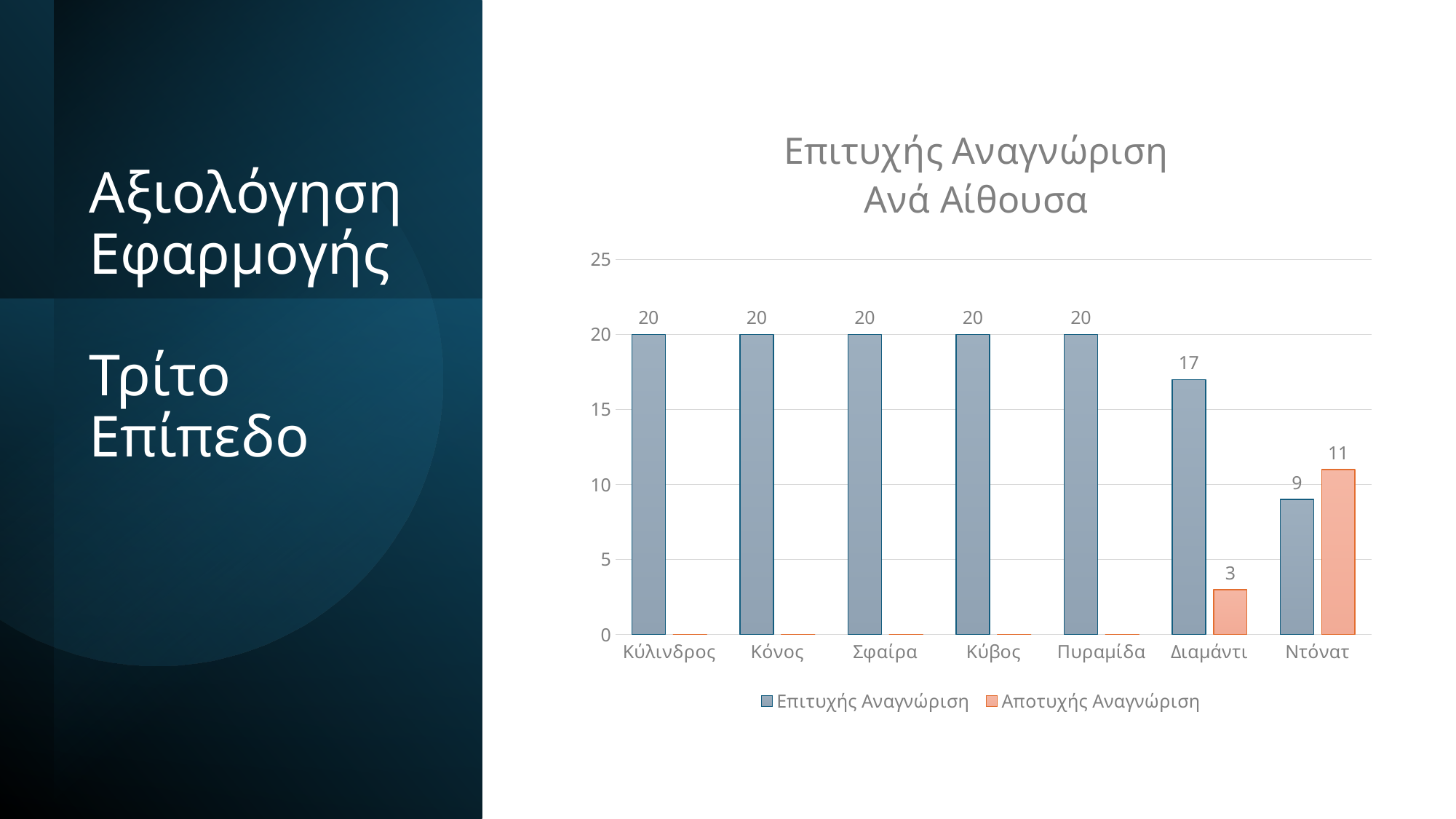
What type of chart is shown on the slide? Bar chart What is the title of the chart? Επιτυχής Αναγνώριση Ανά Αίθουσα What is the difference between Επιτυχής Αναγνώριση for Κύβος and for Ντόνατ? 11 For Ντόνατ, which is larger: Επιτυχής Αναγνώριση or Αποτυχής Αναγνώριση? Αποτυχής Αναγνώριση Is the value of Επιτυχής Αναγνώριση for Διαμάντι greater or less than 15? greater What is the value of Επιτυχής Αναγνώριση for Διαμάντι? 17 Which legend entry is shown in orange? Αποτυχής Αναγνώριση What is the value of Αποτυχής Αναγνώριση for Ντόνατ? 11 How many series does the legend list? 2 Which category has the lowest value for Επιτυχής Αναγνώριση? Ντόνατ What is the value of Αποτυχής Αναγνώριση for Διαμάντι? 3 How many categories are shown on the x axis? 7